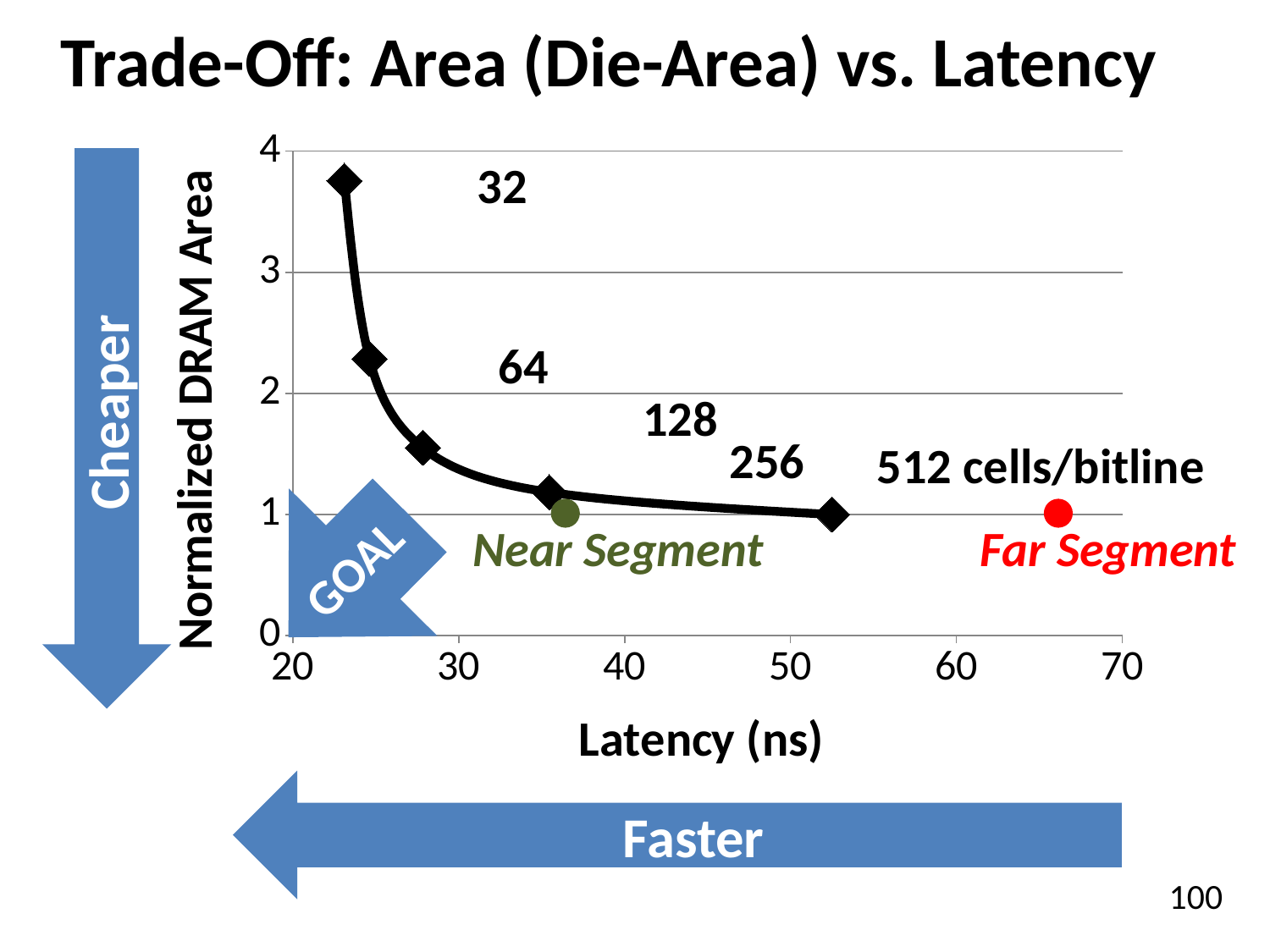
Which cells/bitline configuration has the highest normalized DRAM area? 32 Is the normalized DRAM area for 32 cells/bitline greater or less than 3? greater How many cells/bitline configurations are plotted as black diamond points on the curve? 5 What is the label of the x axis? Latency (ns) What is the title of the slide's chart? Trade-Off: Area (Die-Area) vs. Latency As latency increases along the x axis, does the normalized DRAM area rise or fall? fall Is the latency for the Far Segment point greater or less than 60 ns? greater Is the latency for the Near Segment point greater or less than 40 ns? less Which cells/bitline configuration has the lowest latency? 32